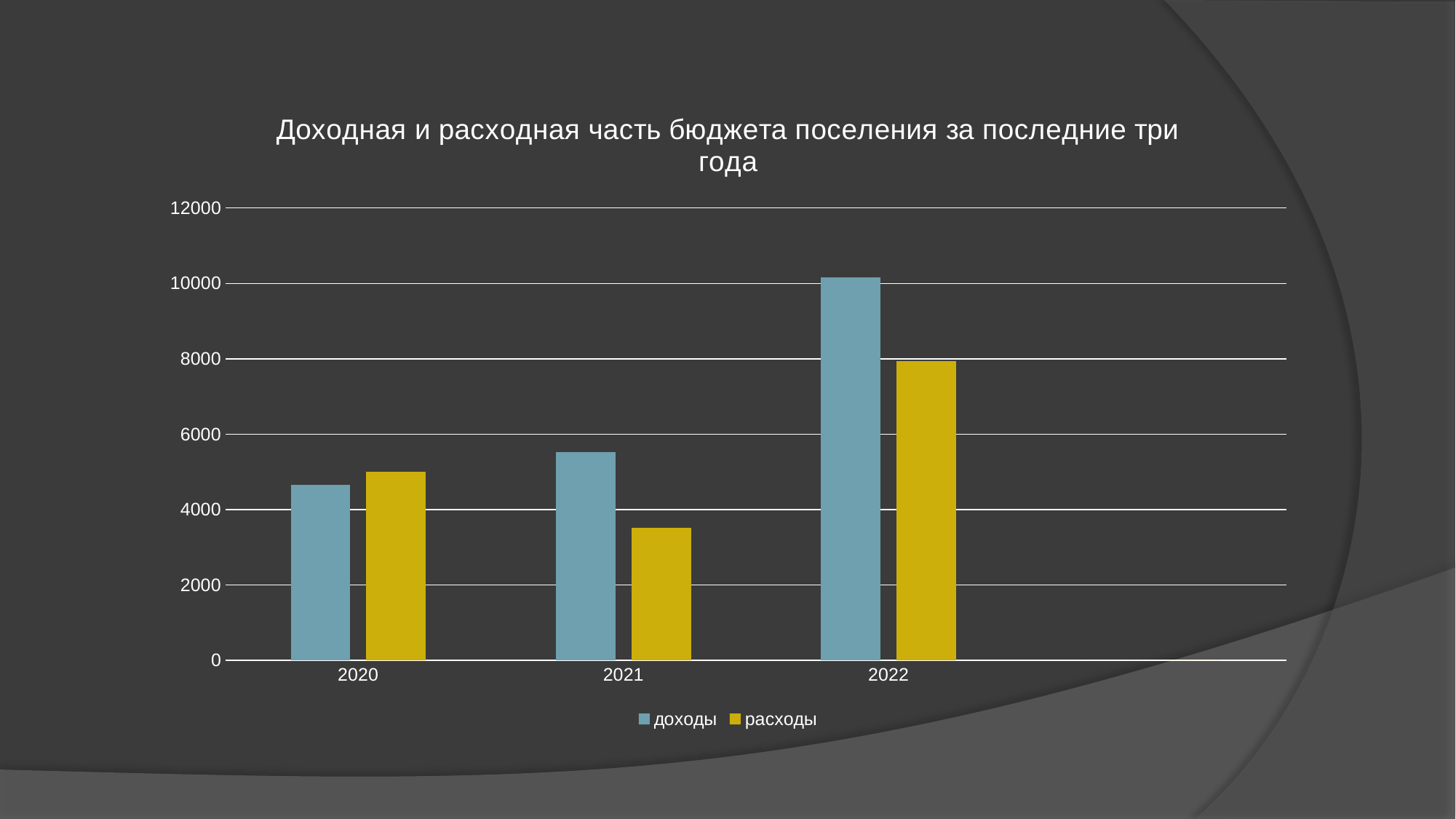
In 2022, which is larger: доходы or расходы? доходы In which year is the value for доходы the lowest? 2020 In 2021, which is larger: доходы or расходы? доходы What kind of chart is shown on the slide? bar chart Do the values for доходы rise or fall from 2020 to 2022? rise Is the value for доходы in 2022 greater or less than 8000? greater Is the value for расходы in 2021 greater or less than 4000? less In which year is the value for доходы the highest? 2022 How many series does the legend list? 2 In which year is the value for расходы the lowest? 2021 How many years are shown on the x axis? 3 In which year is the value for расходы the highest? 2022